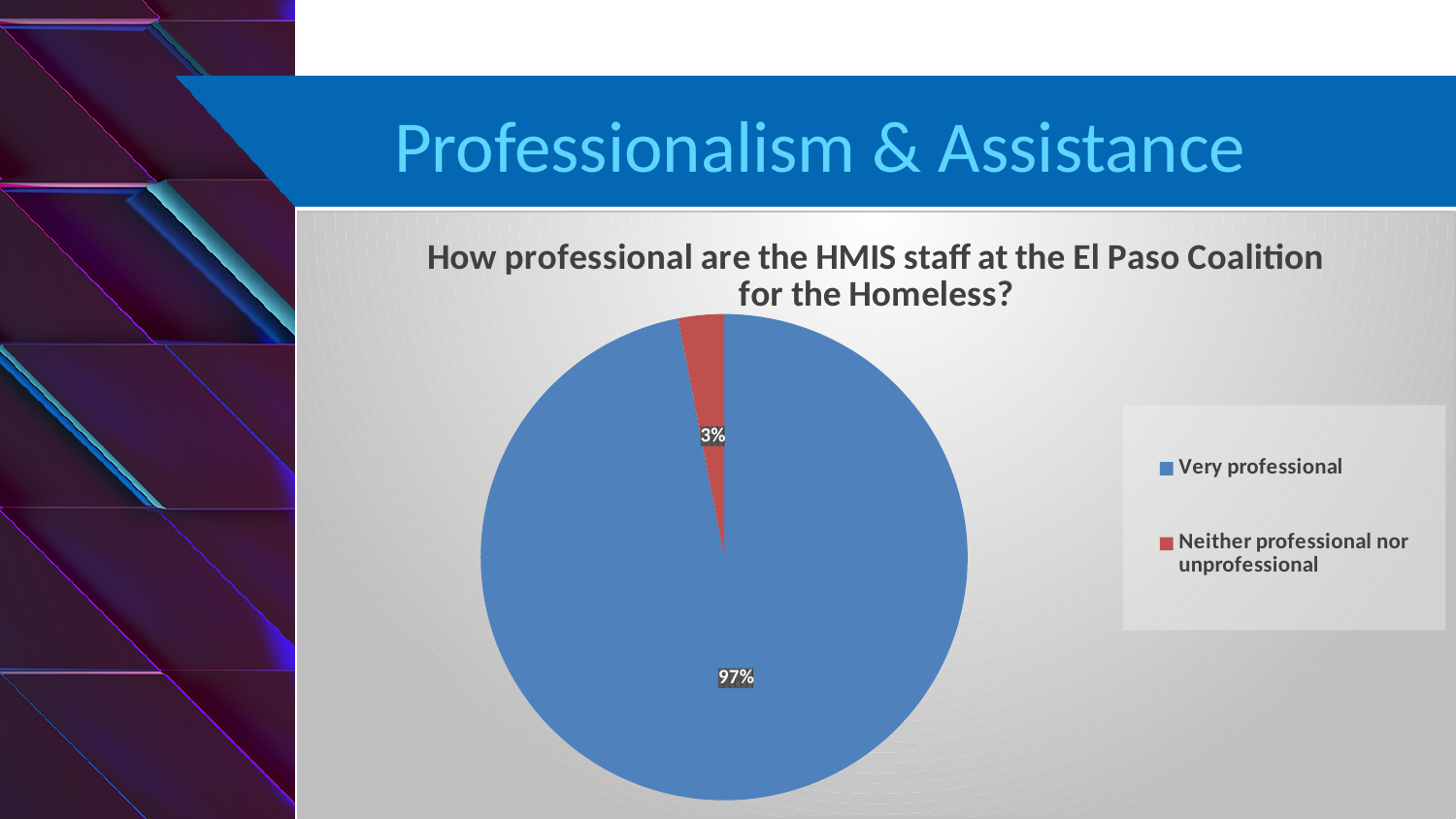
How many categories does the pie chart show? 2 Which category has the largest slice of the pie? Very professional What kind of chart is shown on the slide? pie chart Which category has the smallest slice of the pie? Neither professional nor unprofessional What share of the pie is labelled "Neither professional nor unprofessional"? 3% Which is larger: the "Very professional" slice or the "Neither professional nor unprofessional" slice? Very professional What is the title of the chart? How professional are the HMIS staff at the El Paso Coalition for the Homeless? What colour is the "Neither professional nor unprofessional" slice? red What is the difference in percentage points between the "Very professional" slice and the "Neither professional nor unprofessional" slice? 94 How many entries does the legend list? 2 What share of the pie is labelled "Very professional"? 97%